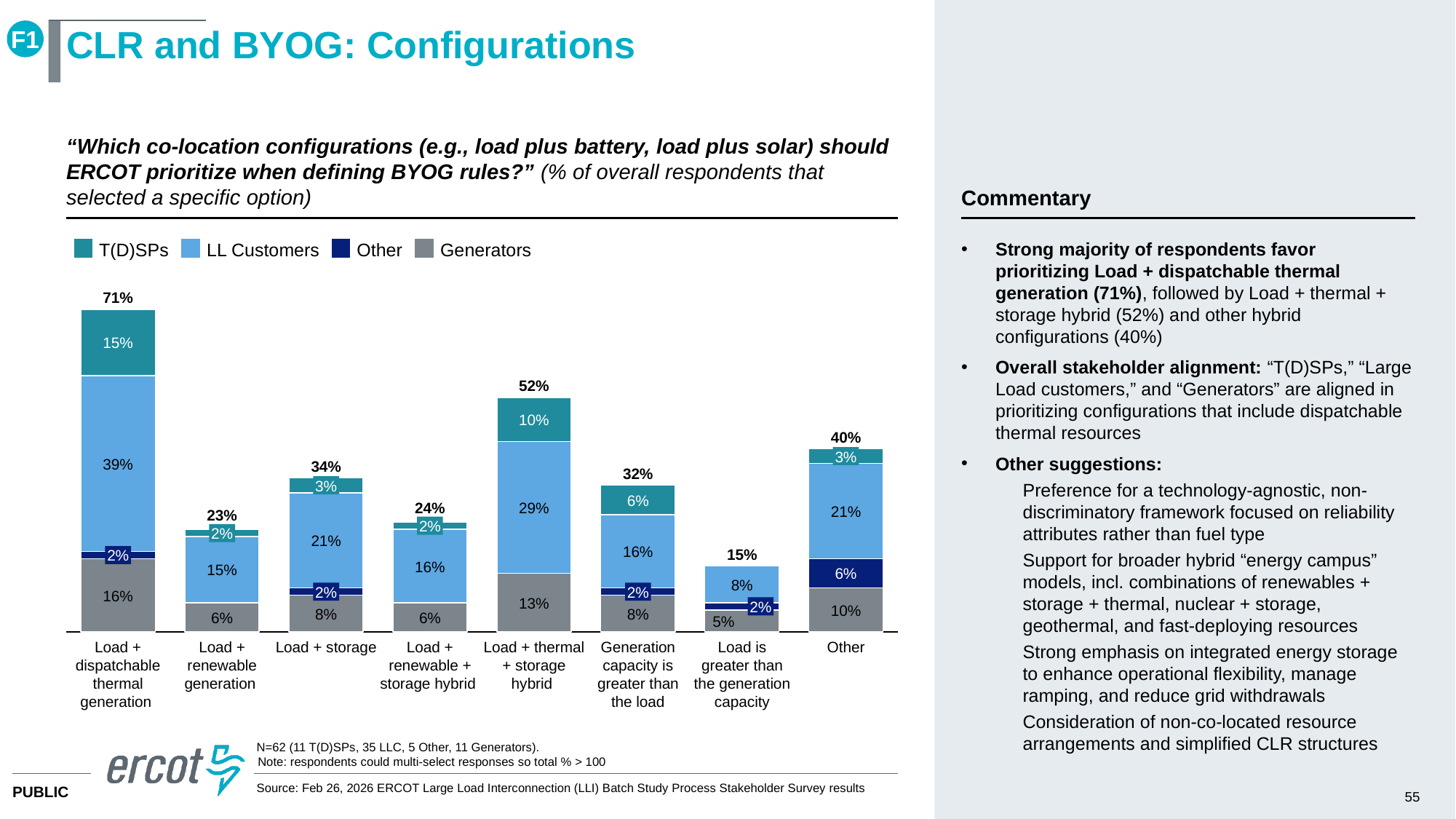
What is the Generators value for Load + dispatchable thermal generation? 16% Which configuration has the lowest total percentage? Load is greater than the generation capacity How many configuration categories are shown on the x axis? 8 What kind of chart is shown on the slide? Stacked bar chart What is the T(D)SPs value for Generation capacity is greater than the load? 6% Which has a larger total percentage, Load + storage or Other? Other Which configuration has the highest total percentage? Load + dispatchable thermal generation How many series does the legend list? 4 Which series is shown in gray in the legend? Generators What is the LL Customers value for Load + thermal + storage hybrid? 29% What is the difference between the total for Load + dispatchable thermal generation and the total for Load + thermal + storage hybrid? 19% What is the total percentage for Load + dispatchable thermal generation? 71%